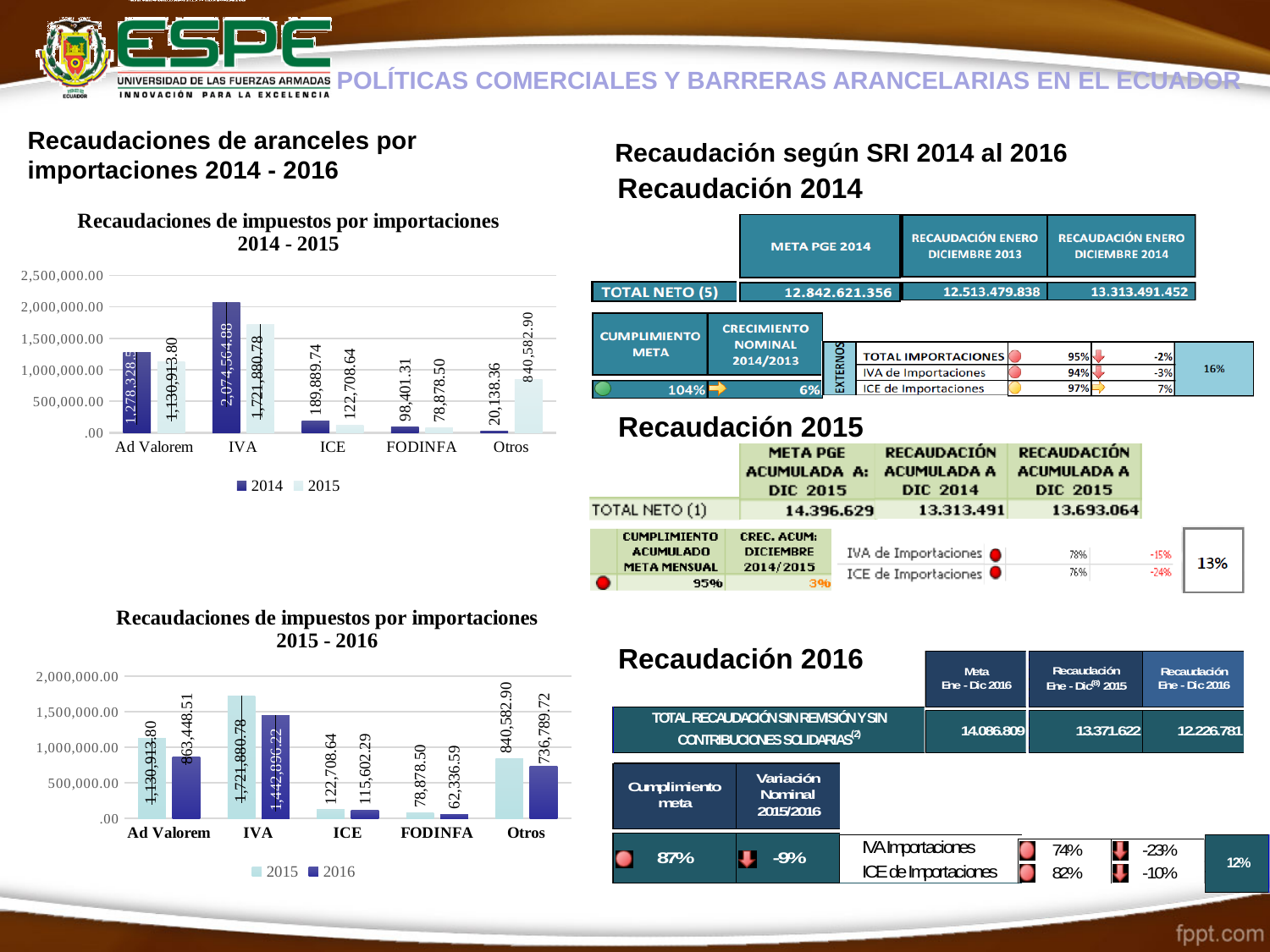
In the chart 'Recaudaciones de impuestos por importaciones 2014 - 2015', which category has the highest 2014 value? IVA In the chart 'Recaudaciones de impuestos por importaciones 2015 - 2016', which is larger: the 2015 value for Otros or the 2016 value for Ad Valorem? 2016 value for Ad Valorem In the chart 'Recaudaciones de impuestos por importaciones 2015 - 2016', what is the difference between the 2015 and 2016 values for FODINFA? 16,541.91 In the chart 'Recaudaciones de impuestos por importaciones 2014 - 2015', what is the 2014 value for Otros? 20,138.36 In the chart 'Recaudaciones de impuestos por importaciones 2015 - 2016', which category has the lowest 2016 value? FODINFA In the chart 'Recaudaciones de impuestos por importaciones 2014 - 2015', what is the difference between the 2014 and 2015 values for ICE? 67,181.10 In the chart 'Recaudaciones de impuestos por importaciones 2014 - 2015', what is the 2015 value for ICE? 122,708.64 In the chart 'Recaudaciones de impuestos por importaciones 2015 - 2016', what is the 2016 value for Otros? 736,789.72 In the chart 'Recaudaciones de impuestos por importaciones 2015 - 2016', what is the 2016 value for Ad Valorem? 863,448.51 In the chart 'Recaudaciones de impuestos por importaciones 2014 - 2015', which category has the lowest 2014 value? Otros In the chart 'Recaudaciones de impuestos por importaciones 2014 - 2015', how many series does the legend list? 2 In the chart 'Recaudaciones de impuestos por importaciones 2015 - 2016', how many categories are shown on the x axis? 5